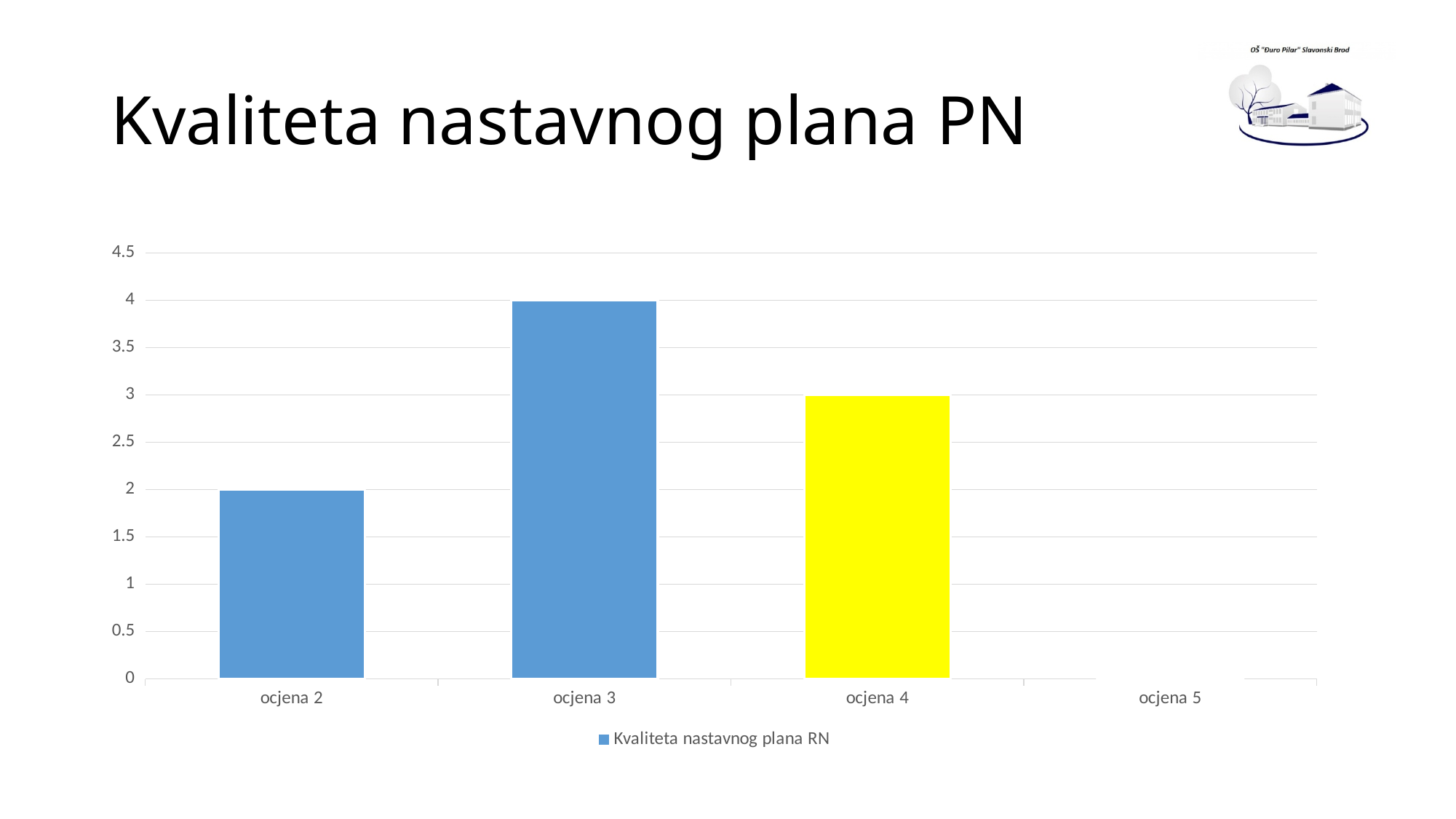
What is the value for ocjena 4? 3 What is the value for ocjena 2? 2 What type of chart is shown on the slide? bar chart What is the value for ocjena 3? 4 Which category has the highest value? ocjena 3 How many series does the legend list? 1 Which category has the lowest value? ocjena 5 Is the value for ocjena 3 greater or less than 3.5? greater What is the difference between the values for ocjena 3 and ocjena 2? 2 What is the series name shown in the legend? Kvaliteta nastavnog plana RN Which is larger, the value for ocjena 4 or the value for ocjena 2? ocjena 4 How many categories are shown on the x axis? 4